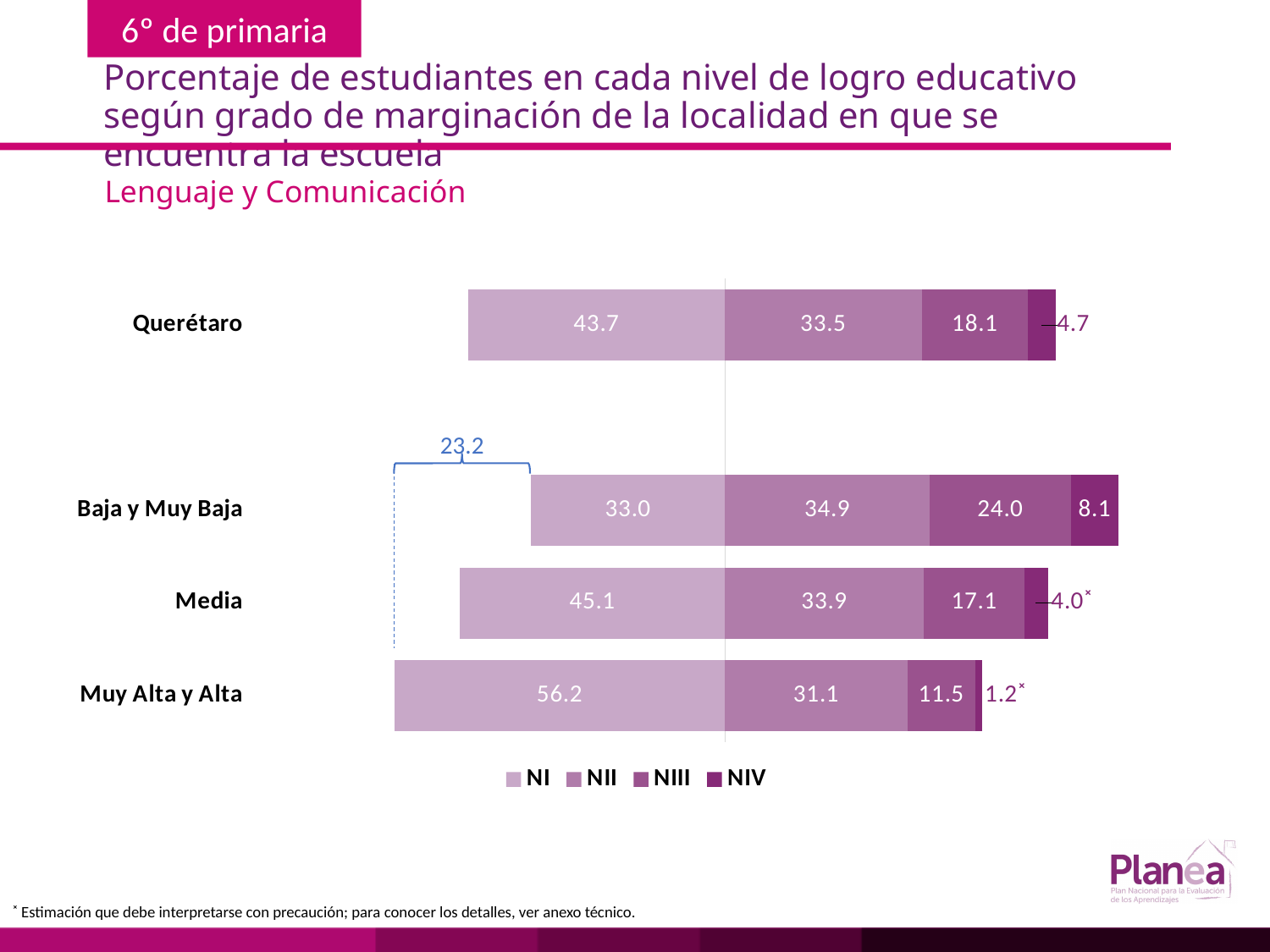
What is the NI value for Muy Alta y Alta? 56.2 Which category has the lowest NIV value? Muy Alta y Alta How many series does the legend list? 4 What is the NII value for Baja y Muy Baja? 34.9 What is the NIV value for Media? 4.0 What is the subtitle shown below the chart title? Lenguaje y Comunicación What is the NIII value for Querétaro? 18.1 How many categories are shown on the chart? 4 What kind of chart is shown on the slide? Stacked bar chart Which is larger, the NIII value for Baja y Muy Baja or the NIII value for Media? Baja y Muy Baja Which category has the highest NI value? Muy Alta y Alta What is the difference between the NI values for Muy Alta y Alta and Baja y Muy Baja? 23.2